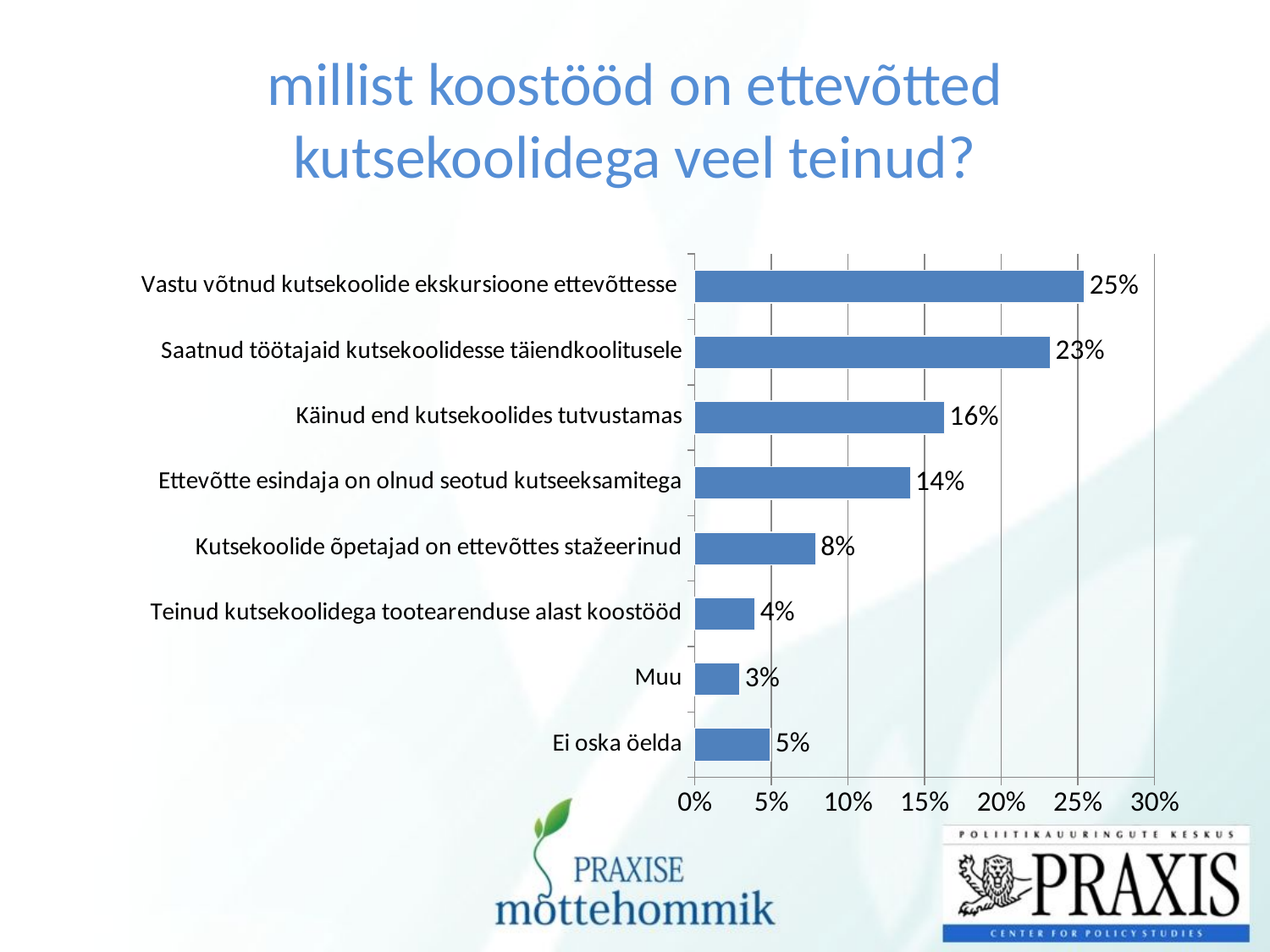
What is the value for "Ei oska öelda"? 5% What kind of chart is shown on the slide? bar chart Which category has the highest value? Vastu võtnud kutsekoolide ekskursioone ettevõttesse What is the difference between the values for "Saatnud töötajaid kutsekoolidesse täiendkoolitusele" and "Ettevõtte esindaja on olnud seotud kutseeksamitega"? 9% How many categories are shown in the chart? 8 What is the value for "Vastu võtnud kutsekoolide ekskursioone ettevõttesse"? 25% What is the title of the slide? millist koostööd on ettevõtted kutsekoolidega veel teinud? Which category has the lowest value? Muu Is the value for "Käinud end kutsekoolides tutvustamas" greater or less than 15%? greater What is the value for "Muu"? 3% What is the value for "Käinud end kutsekoolides tutvustamas"? 16% Which is larger: the value for "Kutsekoolide õpetajad on ettevõttes stažeerinud" or the value for "Teinud kutsekoolidega tootearenduse alast koostööd"? Kutsekoolide õpetajad on ettevõttes stažeerinud